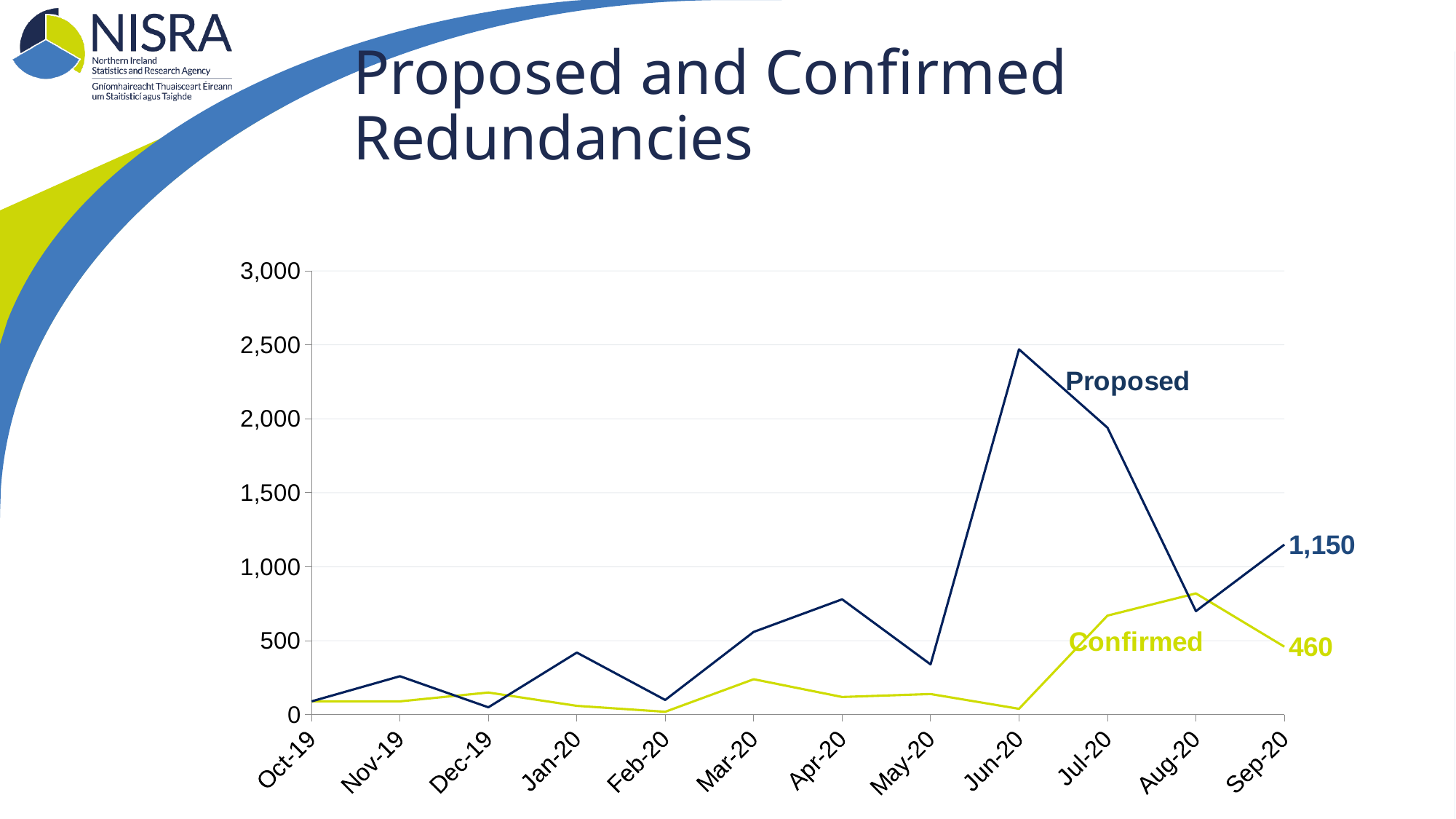
Is the value for Proposed in Jun-20 greater or less than 2,000? greater What is the difference between Proposed and Confirmed redundancies in Sep-20? 690 What is the value of Proposed redundancies in Sep-20? 1,150 How many months are plotted along the x axis? 12 How many data series are plotted on the chart? 2 What kind of chart is shown on the slide? line chart What is the value of Confirmed redundancies in Sep-20? 460 In Aug-20, which series has the larger value, Proposed or Confirmed? Confirmed In which month is the Confirmed series at its highest? Aug-20 In which month is the Proposed series at its lowest? Dec-19 In which month is the Proposed series at its highest? Jun-20 Does the Proposed series rise or fall from Jun-20 to Aug-20? fall